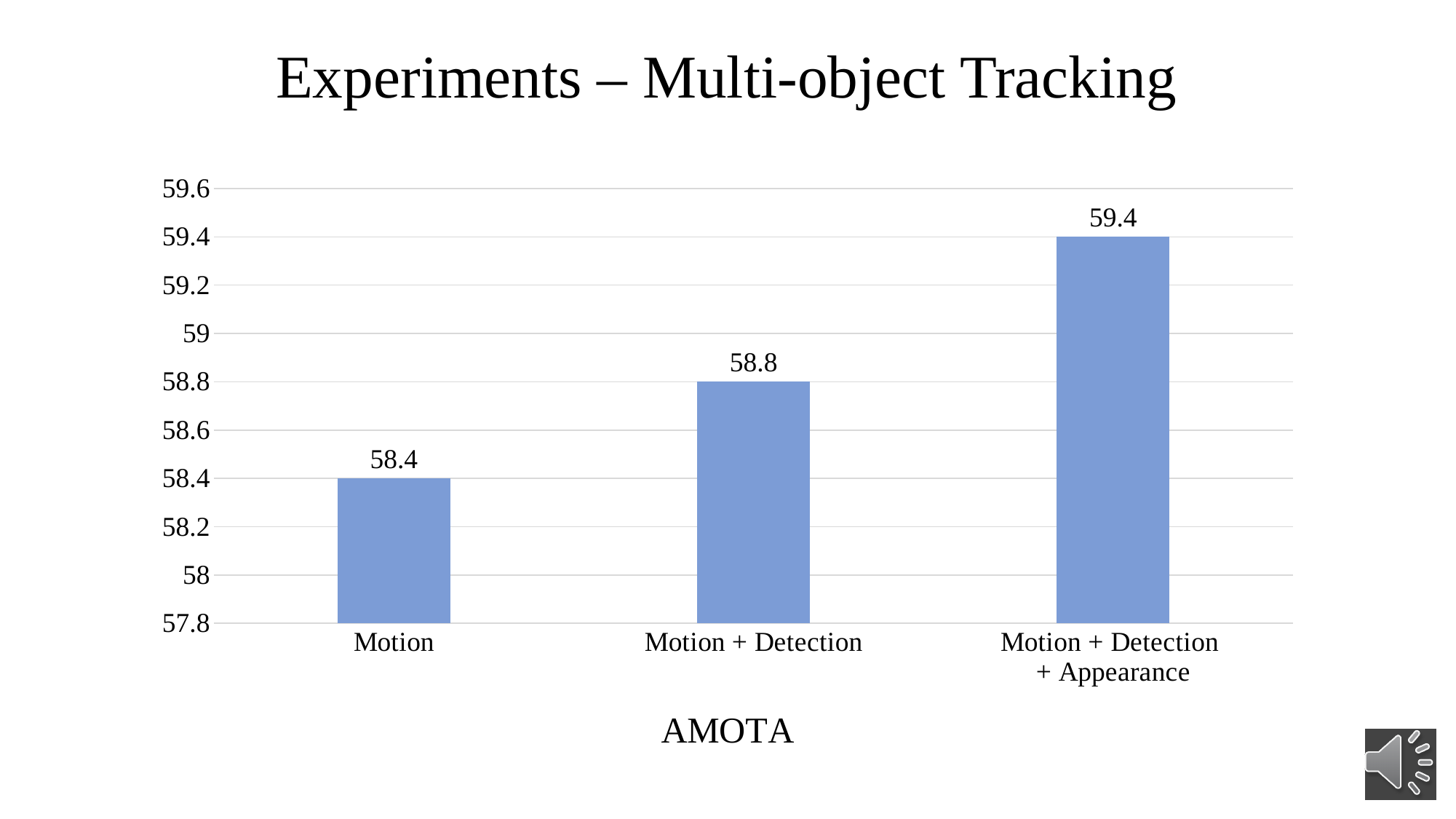
How many categories are shown in the chart? 3 What is the difference in AMOTA between Motion + Detection + Appearance and Motion? 1 What is the AMOTA value for Motion + Detection + Appearance? 59.4 What is the AMOTA value for Motion? 58.4 Is the AMOTA value for Motion + Detection + Appearance greater or less than 59? greater What is the difference in AMOTA between Motion + Detection and Motion? 0.4 Which category has the lowest AMOTA value? Motion Which category has the highest AMOTA value? Motion + Detection + Appearance What kind of chart is shown on the slide? bar chart What is the AMOTA value for Motion + Detection? 58.8 Do the AMOTA values rise or fall from left to right across the categories? rise Which has a higher AMOTA value, Motion + Detection or Motion? Motion + Detection